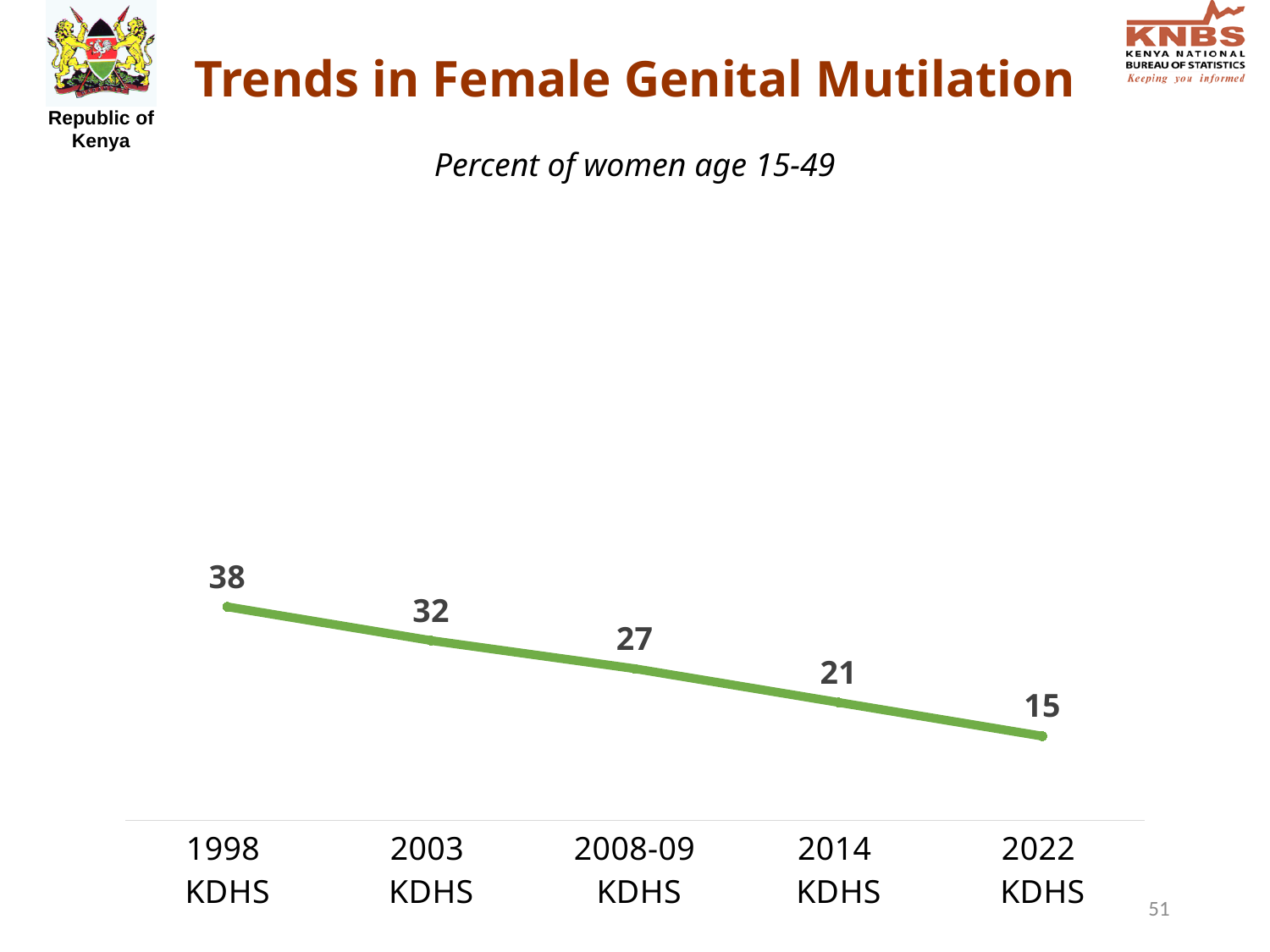
What is the value for 1998 KDHS? 38 What is the value for 2008-09 KDHS? 27 What kind of chart is shown on the slide? line chart What is the title of the chart? Trends in Female Genital Mutilation What is the difference between the values for 1998 KDHS and 2022 KDHS? 23 Do the values rise or fall from 1998 KDHS to 2022 KDHS? fall Which survey has the lowest value? 2022 KDHS Which is larger, the value for 2003 KDHS or the value for 2008-09 KDHS? 2003 KDHS Which survey has the highest value? 1998 KDHS What is the value for 2014 KDHS? 21 What is the difference between the values for 2003 KDHS and 2014 KDHS? 11 How many data points are plotted on the chart? 5